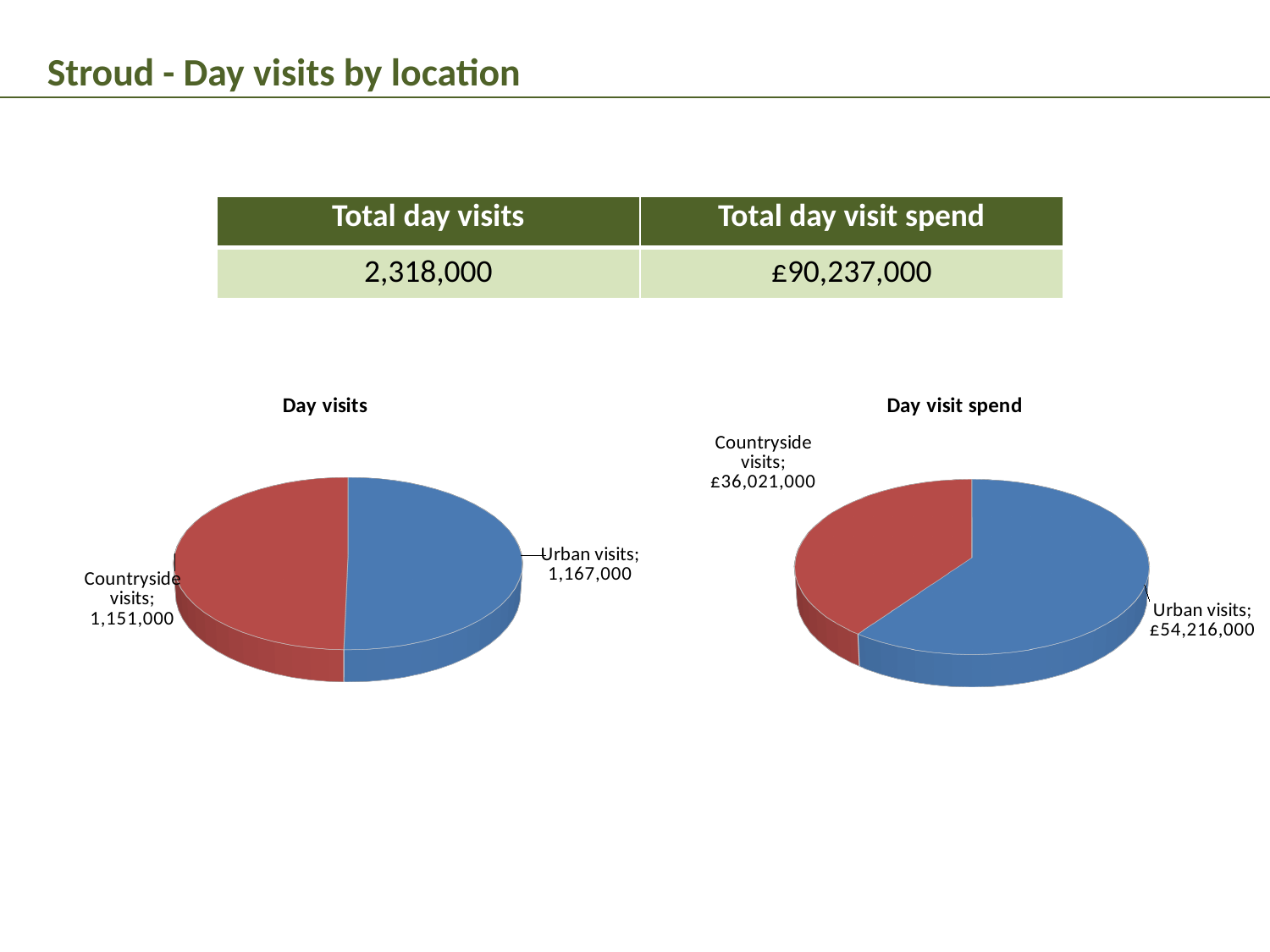
On the Day visit spend chart, which category has the largest slice? Urban visits On the Day visit spend chart, what is the total of the two slices? £90,237,000 On the Day visits chart, what is the difference between Urban visits and Countryside visits? 16,000 On the Day visit spend chart, what is the value for Urban visits? £54,216,000 What kind of chart is the Day visit spend chart? Pie chart On the Day visits chart, what is the value for Countryside visits? 1,151,000 On the Day visits chart, which is larger, Urban visits or Countryside visits? Urban visits On the Day visit spend chart, what is the difference between Urban visits and Countryside visits? £18,195,000 On the Day visit spend chart, what is the value for Countryside visits? £36,021,000 On the Day visits chart, what is the value for Urban visits? 1,167,000 How many slices does the Day visits chart have? 2 On the Day visit spend chart, which category has the smallest slice? Countryside visits